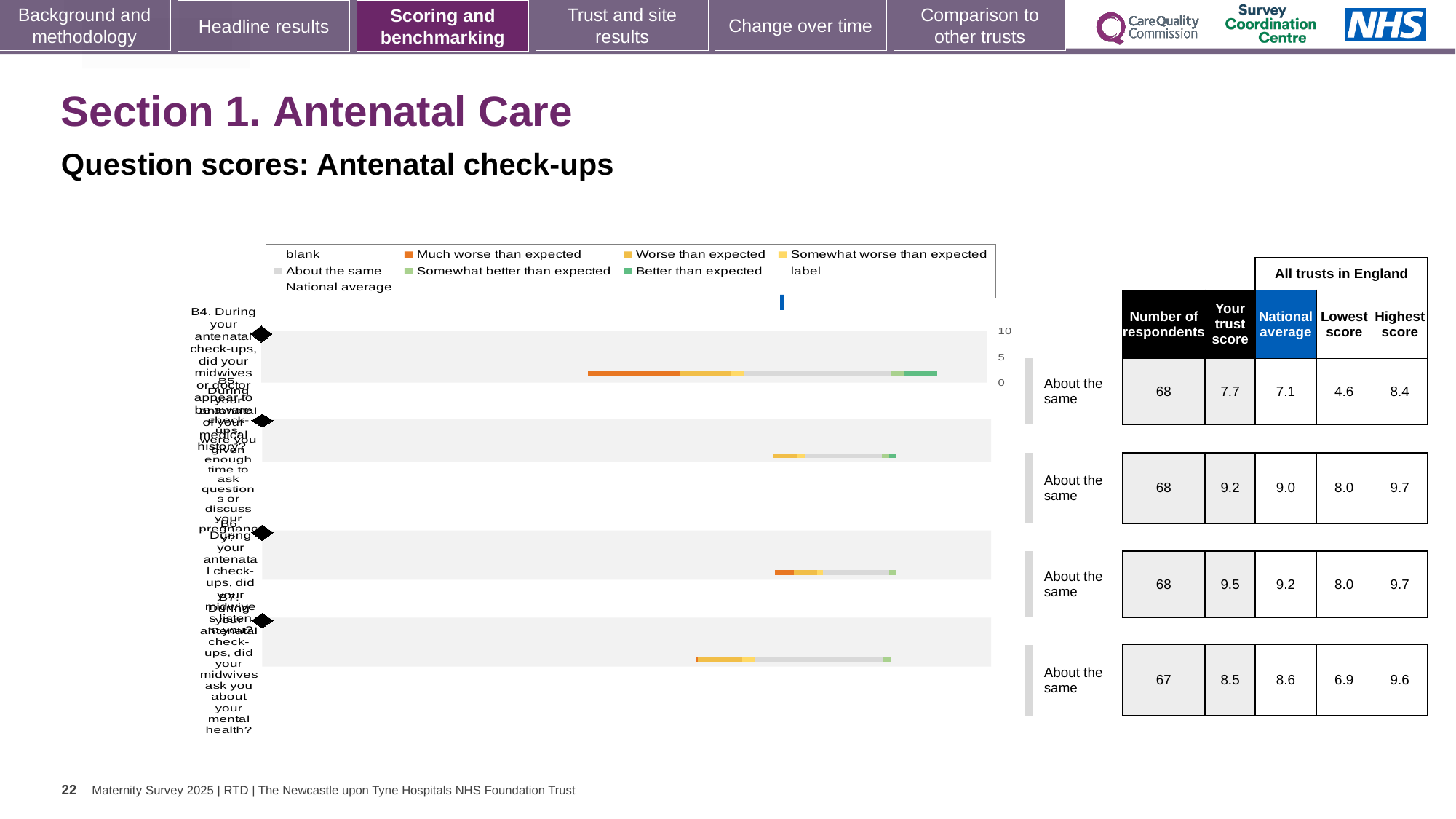
What kind of chart is shown on the slide? bar chart In the table beside the chart, what is the number of respondents for the fourth (bottom) question, B7? 67 In the table beside the chart, what is the national average for the first (top) question, B4? 7.1 In the table beside the chart, which question has the lowest 'Your trust score'? B4 (top bar), 7.7 In the table beside the chart, which question has the highest 'Your trust score'? B6 (third bar), 9.5 In the table beside the chart, what is the 'Your trust score' for the first (top) question, B4? 7.7 How many entries does the chart legend list? 9 How many question bars are plotted in the chart? 4 What colour does the legend use for 'Much worse than expected'? orange In the table beside the chart, is the trust score for the fourth (bottom) question, B7, higher or lower than its national average? lower In the table beside the chart, what is the difference between the trust score and the national average for the first (top) question, B4? 0.6 What is the benchmark category shown beside each of the four bars? About the same